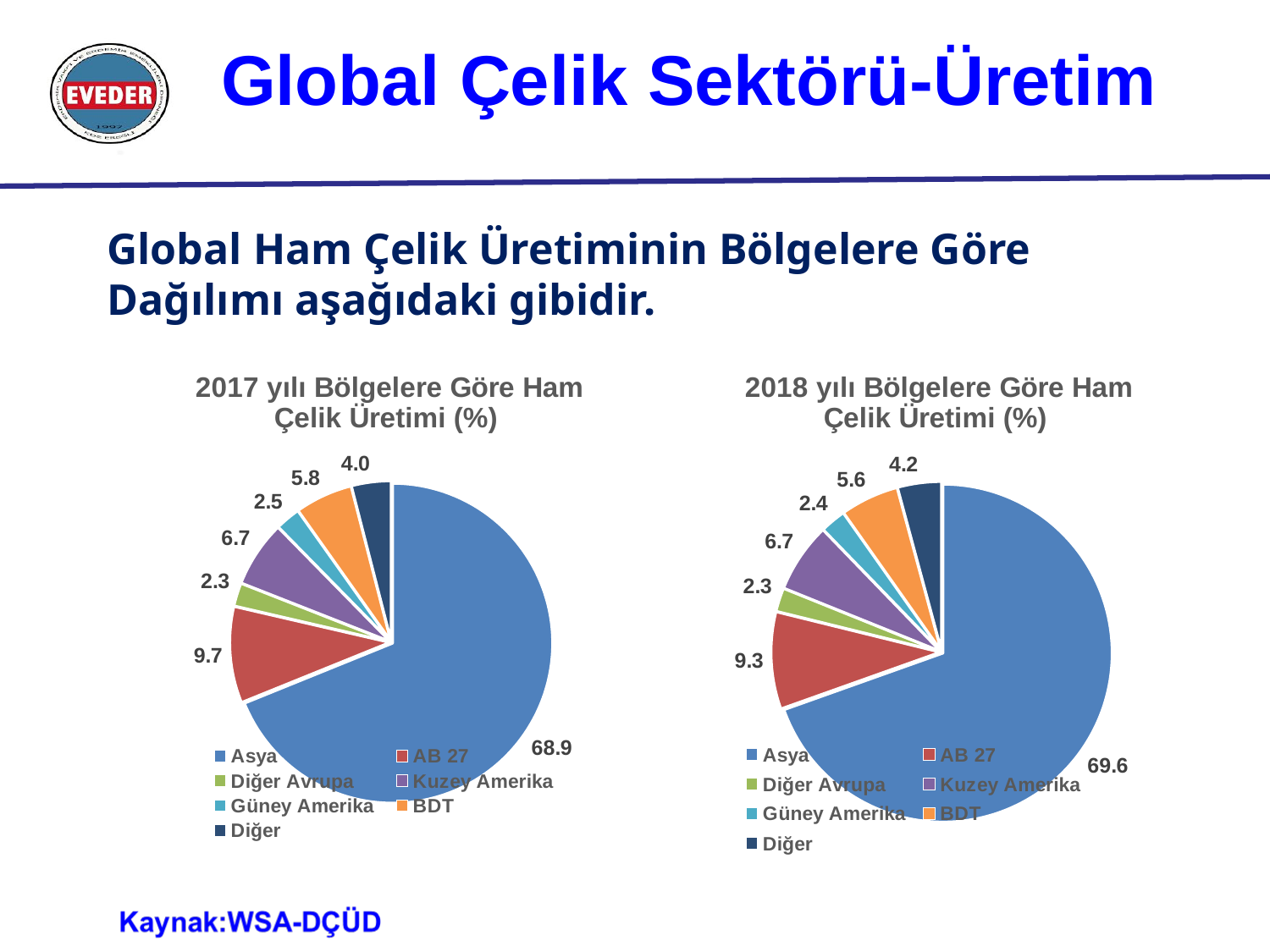
How many entries does the legend of the 2018 pie chart (right) list? 7 In the 2017 pie chart (left), what is the difference between the values for AB 27 and Kuzey Amerika? 3.0 In the 2017 pie chart (left), which region has the smallest share? Diğer Avrupa In the 2017 pie chart (left), what is the value for Kuzey Amerika? 6.7 In the 2017 pie chart (left), what is the value for Asya? 68.9 What is the title of the left chart? 2017 yılı Bölgelere Göre Ham Çelik Üretimi (%) In the 2018 pie chart (right), what is the value for BDT? 5.6 In the 2018 pie chart (right), which region has the largest share? Asya In the 2018 pie chart (right), which is larger, the value for Diğer or the value for Güney Amerika? Diğer In the 2018 pie chart (right), what is the value for AB 27? 9.3 How many slices does the 2017 pie chart (left) have? 7 What kind of chart is the chart titled '2018 yılı Bölgelere Göre Ham Çelik Üretimi (%)'? Pie chart